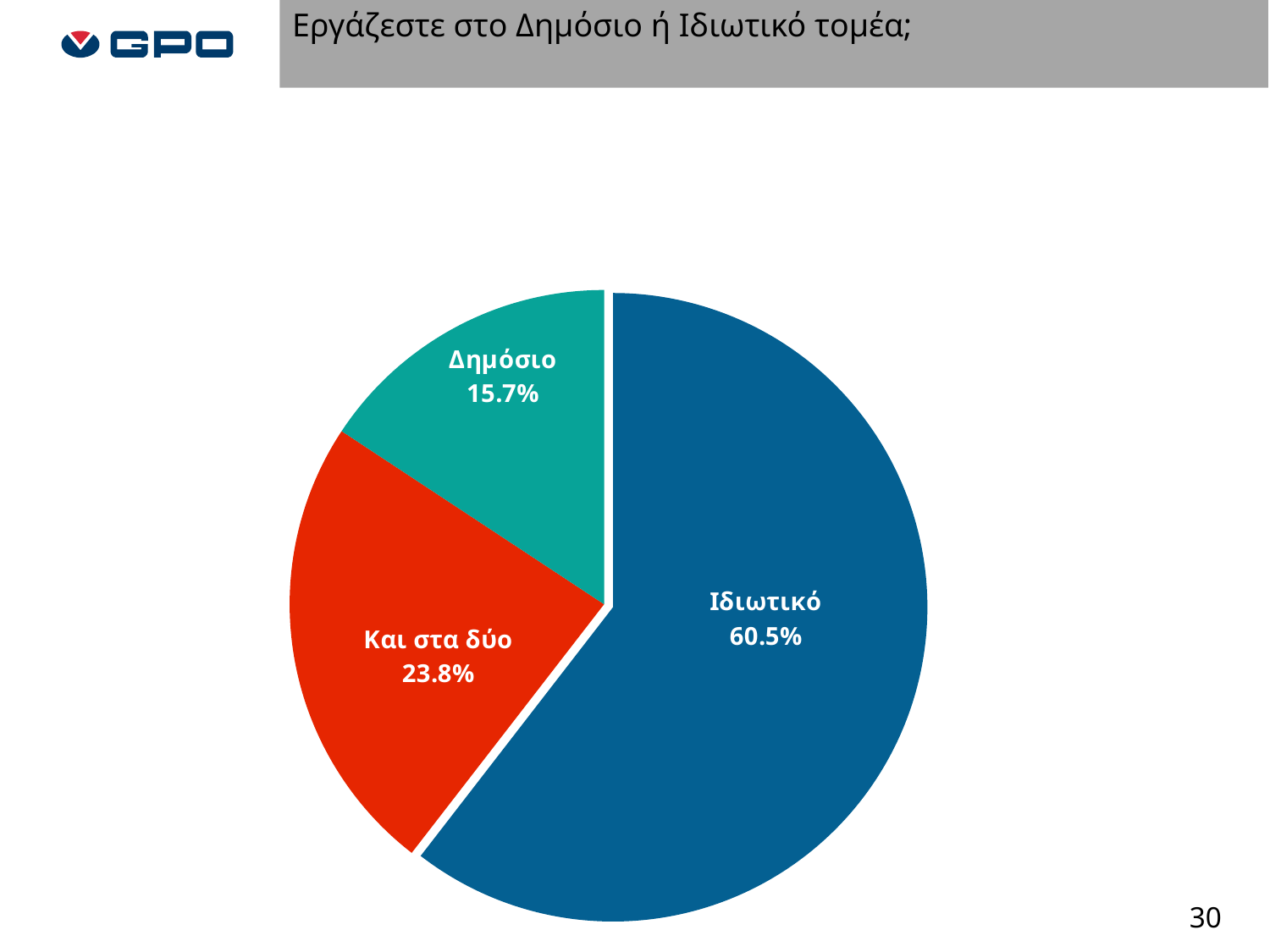
What is the value for Και στα δύο? 23.8% How many categories does the pie chart show? 3 What is the difference between the values for Και στα δύο and Δημόσιο? 8.1% Which category has the smallest share of the pie? Δημόσιο What is the value for Ιδιωτικό? 60.5% What kind of chart is shown on the slide? pie chart What is the title of the slide containing the chart? Εργάζεστε στο Δημόσιο ή Ιδιωτικό τομέα; What colour is the slice for Και στα δύο? red What is the difference between the values for Ιδιωτικό and Και στα δύο? 36.7% Which category has the largest share of the pie? Ιδιωτικό Which is larger, the value for Και στα δύο or the value for Δημόσιο? Και στα δύο What is the value for Δημόσιο? 15.7%